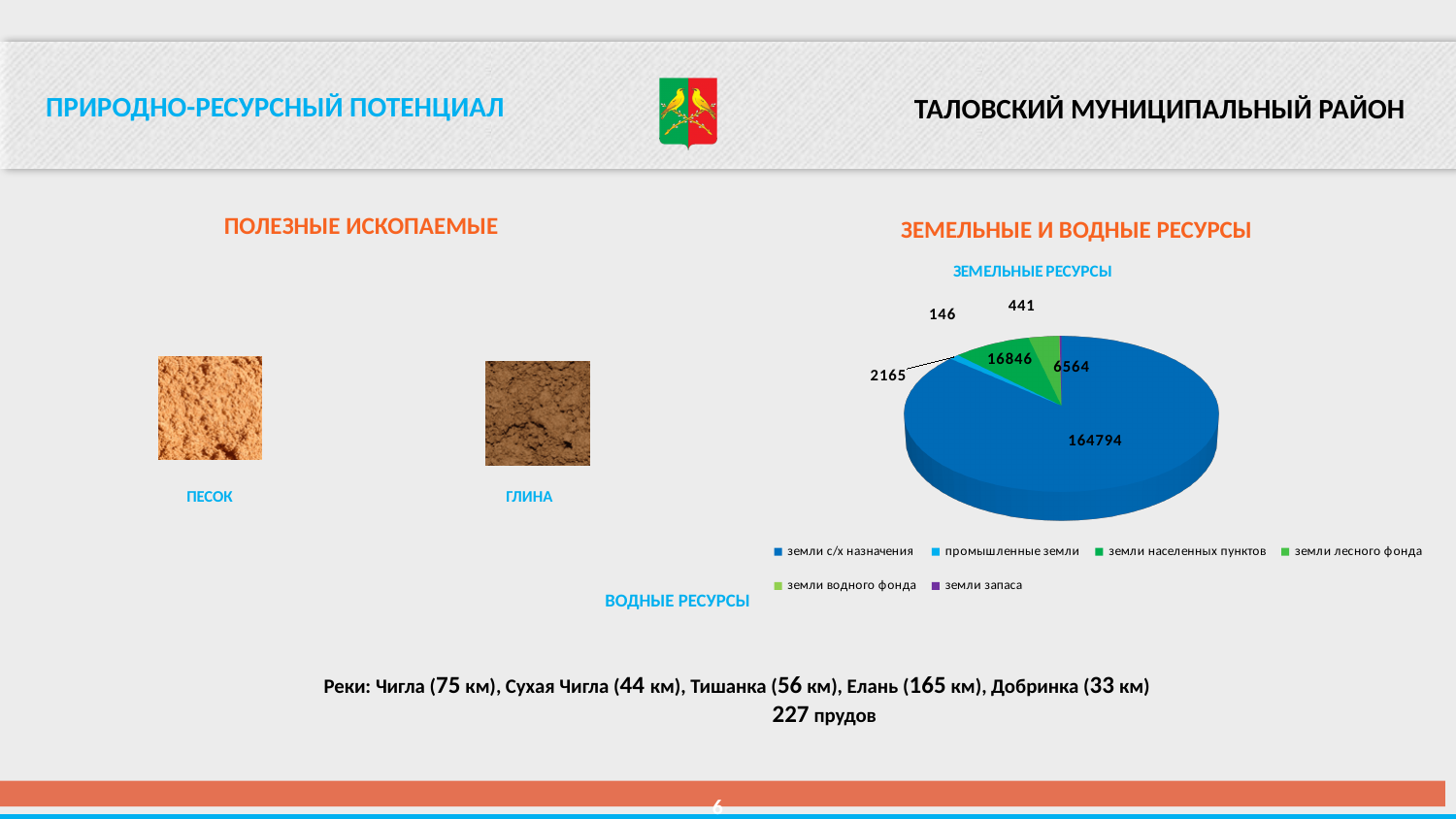
In the ЗЕМЕЛЬНЫЕ РЕСУРСЫ pie chart, what is the value for земли с/х назначения? 164794 In the ЗЕМЕЛЬНЫЕ РЕСУРСЫ pie chart, which category has the largest slice? земли с/х назначения What is the title of the pie chart on the slide? ЗЕМЕЛЬНЫЕ РЕСУРСЫ What is the smallest value printed on the ЗЕМЕЛЬНЫЕ РЕСУРСЫ pie chart? 146 How many data labels are printed on the ЗЕМЕЛЬНЫЕ РЕСУРСЫ pie chart? 6 In the ЗЕМЕЛЬНЫЕ РЕСУРСЫ pie chart, which is larger: the slice labelled 2165 or the slice labelled 441? 2165 What is the second-largest value printed on the ЗЕМЕЛЬНЫЕ РЕСУРСЫ pie chart? 16846 What kind of chart is shown under the heading ЗЕМЕЛЬНЫЕ РЕСУРСЫ? pie chart In the ЗЕМЕЛЬНЫЕ РЕСУРСЫ pie chart, what is the difference between the values 16846 and 6564? 10282 In the ЗЕМЕЛЬНЫЕ РЕСУРСЫ pie chart, what is the difference between the largest value 164794 and the second-largest value 16846? 147948 How many entries does the legend of the ЗЕМЕЛЬНЫЕ РЕСУРСЫ pie chart list? 6 What is the largest value printed on the ЗЕМЕЛЬНЫЕ РЕСУРСЫ pie chart? 164794